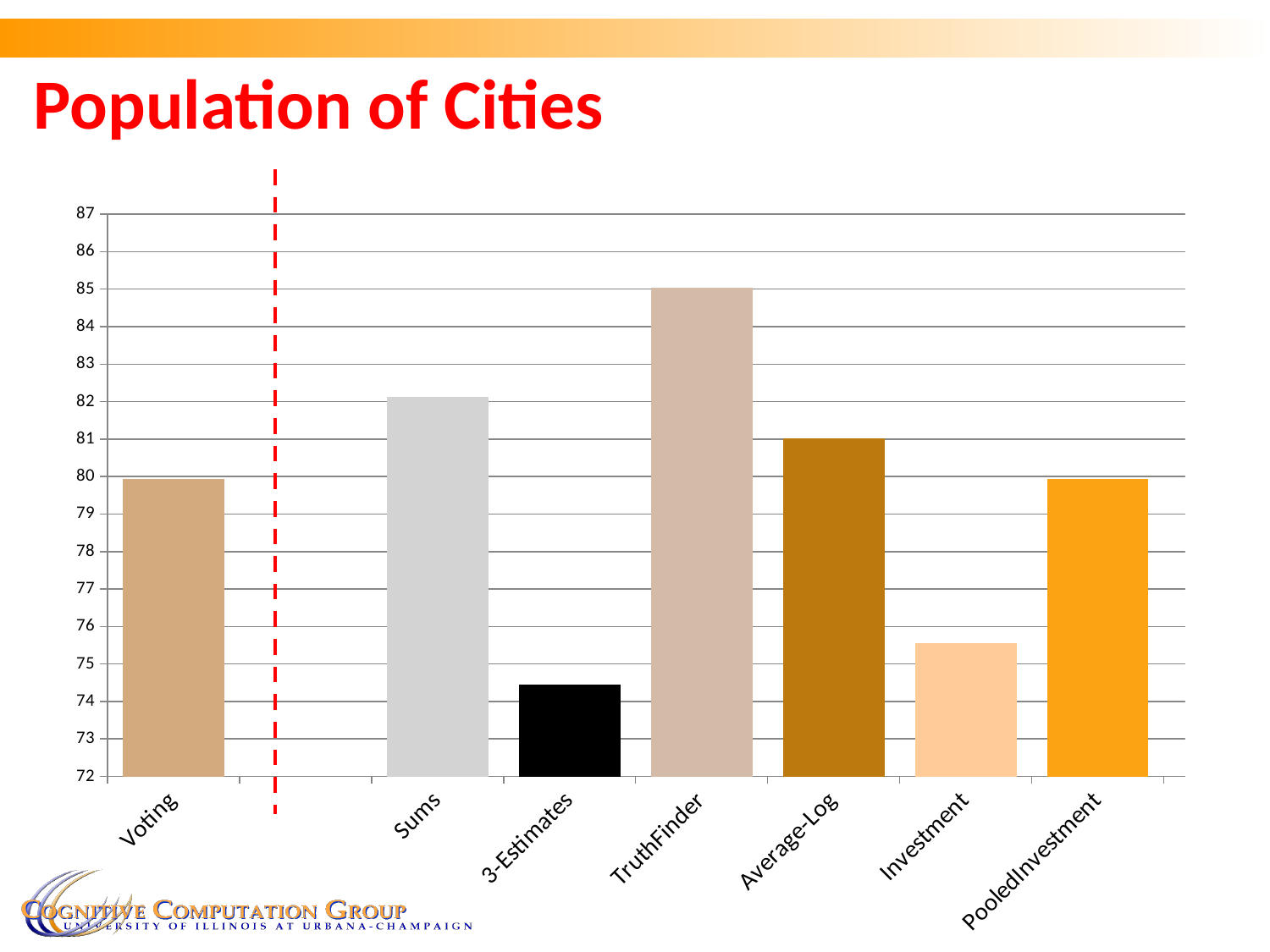
Which is larger, the value for Sums or the value for Average-Log? Sums Is the value for Investment greater or less than 76? less Which category has the highest value? TruthFinder Is the value for Average-Log greater or less than 80? greater Is the value for TruthFinder greater or less than 84? greater What kind of chart is shown on the slide? bar chart Which category has the lowest value? 3-Estimates What is the title of the slide? Population of Cities How many bars are plotted in the chart? 7 Which bar is coloured black? 3-Estimates